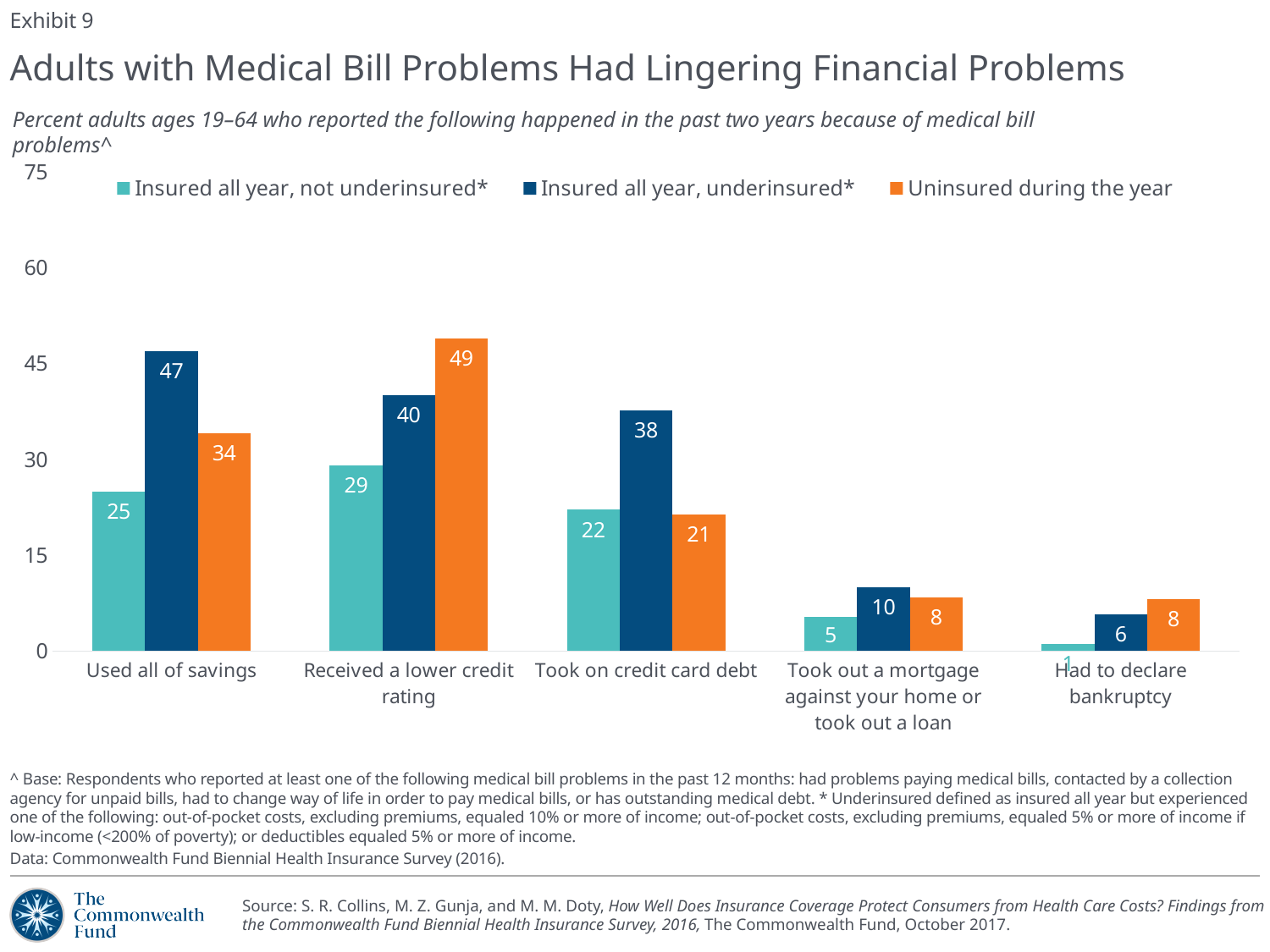
How many series does the legend list? 3 What kind of chart is shown on the slide? Bar chart What colour are the bars for 'Uninsured during the year'? Orange What is the value for 'Insured all year, underinsured*' in the 'Used all of savings' category? 47 How many categories are shown on the x axis? 5 Is the value for 'Uninsured during the year' in the 'Used all of savings' category greater or less than 30? greater What is the value for 'Uninsured during the year' in the 'Received a lower credit rating' category? 49 What is the difference between the 'Insured all year, underinsured*' and 'Insured all year, not underinsured*' values in the 'Used all of savings' category? 22 What is the value for 'Insured all year, not underinsured*' in the 'Took on credit card debt' category? 22 Which category has the highest value for 'Insured all year, underinsured*'? Used all of savings In the 'Took on credit card debt' category, which is larger: the value for 'Insured all year, underinsured*' or for 'Uninsured during the year'? Insured all year, underinsured*